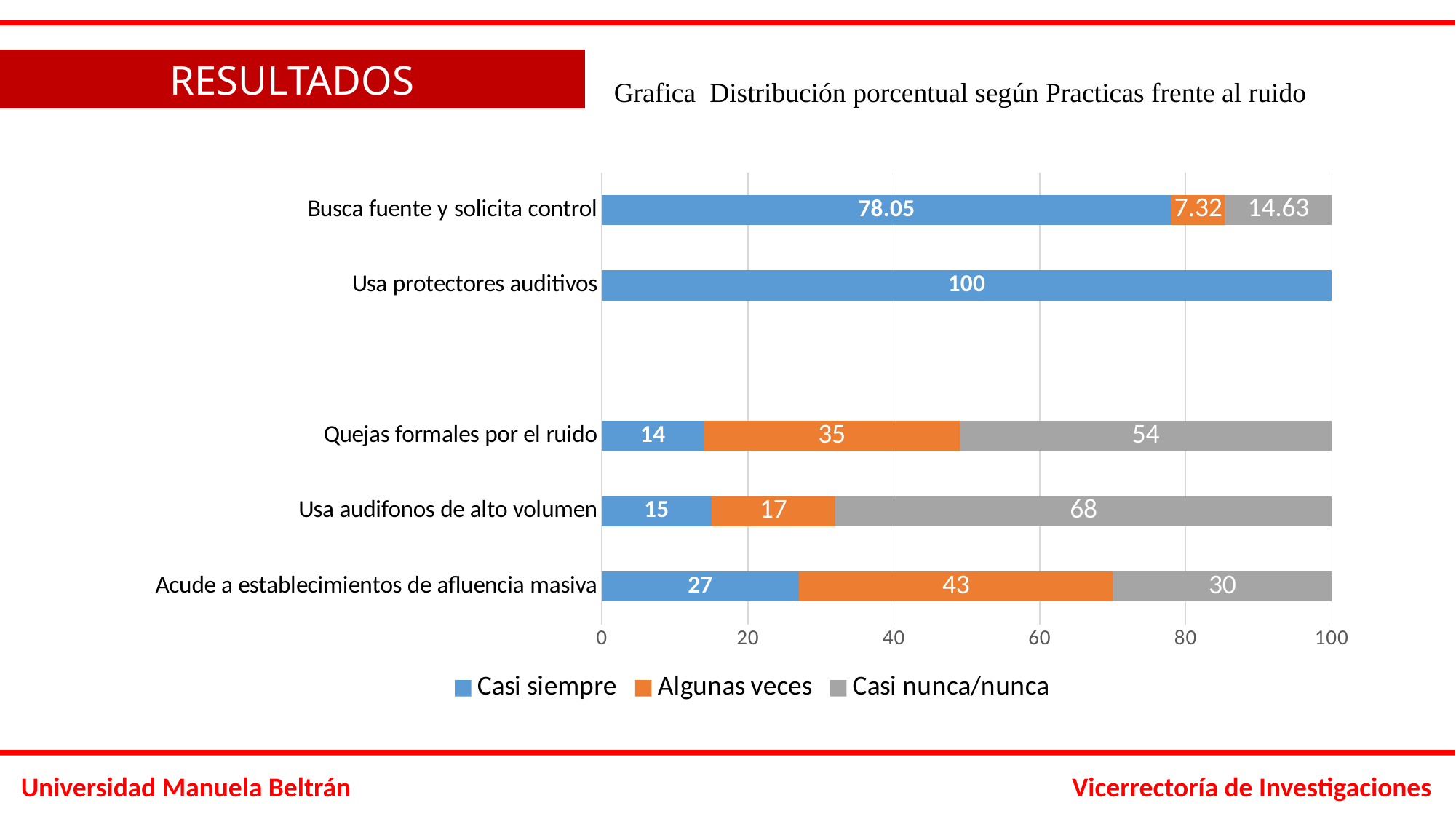
What kind of chart is shown on the slide? Stacked bar chart What is the 'Algunas veces' value for 'Acude a establecimientos de afluencia masiva'? 43 Which is larger: the 'Algunas veces' value for 'Quejas formales por el ruido' or for 'Usa audifonos de alto volumen'? Quejas formales por el ruido How many series does the legend list? 3 What is the total of the stacked bar for 'Busca fuente y solicita control'? 100 What is the difference between the 'Casi nunca/nunca' values for 'Usa audifonos de alto volumen' and 'Quejas formales por el ruido'? 14 What is the 'Casi siempre' value for 'Usa protectores auditivos'? 100 Which colour represents the 'Algunas veces' series? Orange What is the 'Casi nunca/nunca' value for 'Usa audifonos de alto volumen'? 68 Which category has the lowest 'Casi siempre' value? Quejas formales por el ruido Which category has the highest 'Casi siempre' value? Usa protectores auditivos What is the 'Casi siempre' value for 'Busca fuente y solicita control'? 78.05